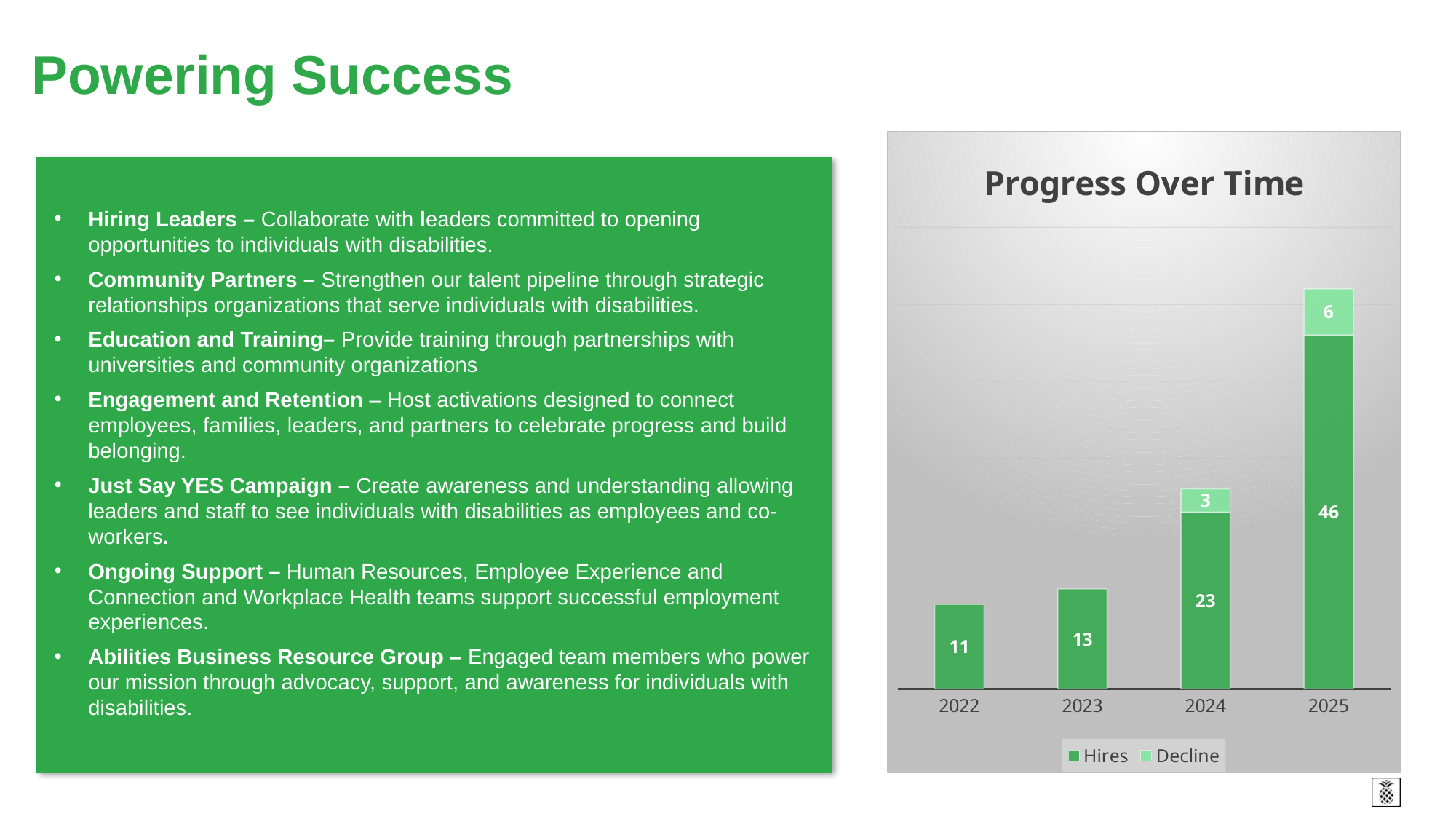
How many years are shown on the x axis of the chart? 4 What is the Hires value for 2024? 23 Do the Hires values rise or fall from 2022 to 2025? Rise Which year has the lowest Hires value? 2022 What is the title of the chart? Progress Over Time What is the total of the stacked bar for 2025? 52 What is the Hires value for 2022? 11 What is the Decline value for 2025? 6 What is the difference between the Hires values for 2025 and 2024? 23 How many series does the chart legend list? 2 Which year has the highest Hires value? 2025 What kind of chart is shown on the slide? Stacked bar chart